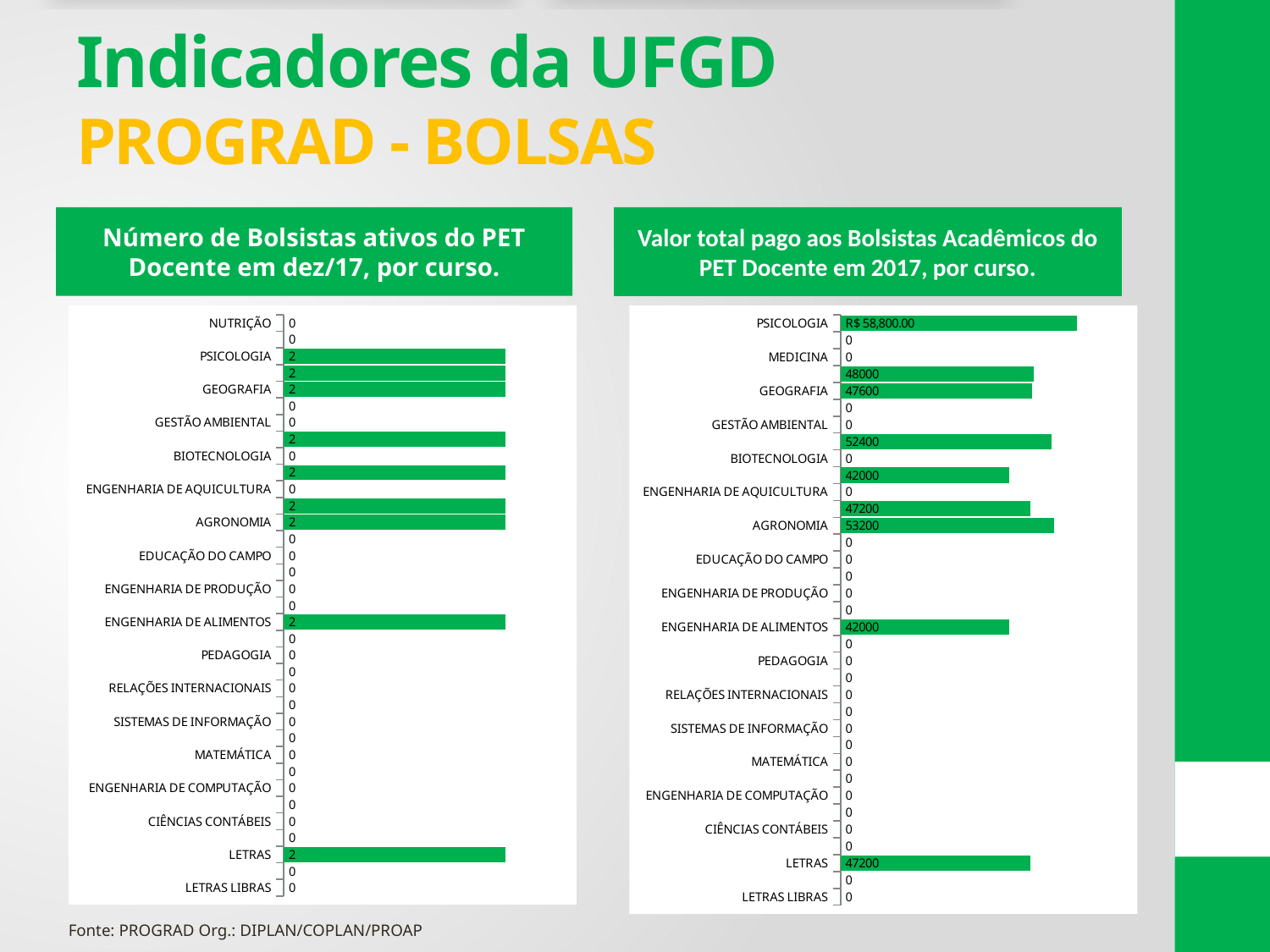
In the chart 'Valor total pago aos Bolsistas Acadêmicos do PET Docente em 2017, por curso.', what is the value for GEOGRAFIA? 47600 In the chart 'Número de Bolsistas ativos do PET Docente em dez/17, por curso.', what is the value for ENGENHARIA DE ALIMENTOS? 2 In the chart 'Valor total pago aos Bolsistas Acadêmicos do PET Docente em 2017, por curso.', which is larger, the value for ENGENHARIA DE ALIMENTOS or the value for LETRAS? LETRAS In the chart 'Número de Bolsistas ativos do PET Docente em dez/17, por curso.', what is the value for PSICOLOGIA? 2 In the chart 'Valor total pago aos Bolsistas Acadêmicos do PET Docente em 2017, por curso.', what is the difference between the values for AGRONOMIA and GEOGRAFIA? 5600 In the chart 'Valor total pago aos Bolsistas Acadêmicos do PET Docente em 2017, por curso.', what is the value for LETRAS? 47200 In the chart 'Valor total pago aos Bolsistas Acadêmicos do PET Docente em 2017, por curso.', what is the value for AGRONOMIA? 53200 In the chart 'Valor total pago aos Bolsistas Acadêmicos do PET Docente em 2017, por curso.', what is the value for PSICOLOGIA? R$ 58,800.00 In the chart 'Número de Bolsistas ativos do PET Docente em dez/17, por curso.', what is the value for NUTRIÇÃO? 0 What kind of chart is the chart on the left of the slide? Bar chart In the chart 'Valor total pago aos Bolsistas Acadêmicos do PET Docente em 2017, por curso.', which labelled course has the highest value? PSICOLOGIA In the chart 'Número de Bolsistas ativos do PET Docente em dez/17, por curso.', which is larger, the value for LETRAS or the value for LETRAS LIBRAS? LETRAS